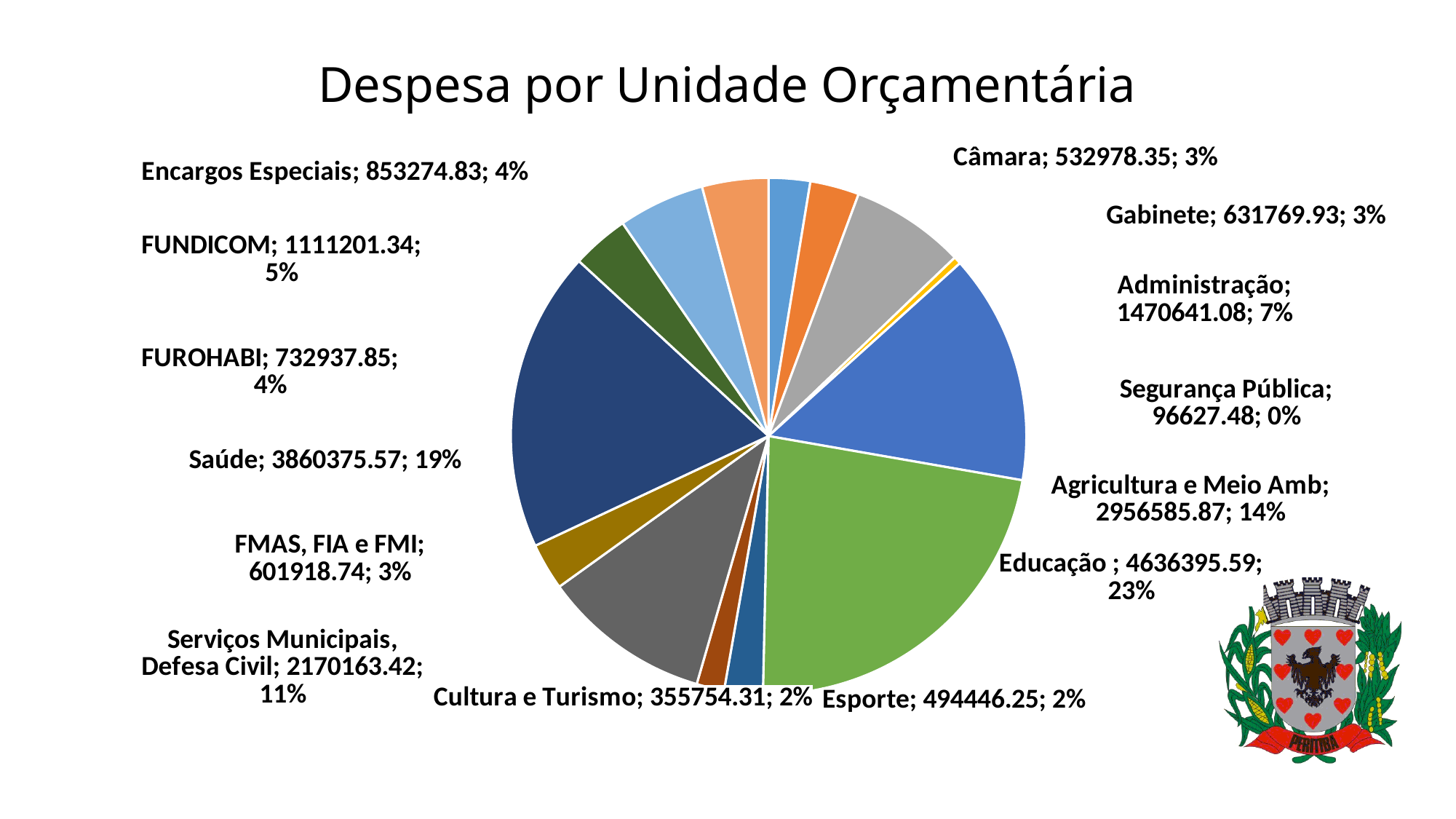
What type of chart is shown on the slide? Pie chart Which unit has the largest expense? Educação Which unit has the smallest expense? Segurança Pública What percentage share does Serviços Municipais, Defesa Civil have? 11% What is the value shown for Saúde? 3860375.57 What is the difference between the values for Educação and Saúde? 776020.02 What is the difference between the values for Administração and Gabinete? 838871.15 What percentage share does Educação have? 23% What is the value shown for Administração? 1470641.08 Which is larger, the value for Agricultura e Meio Amb or the value for Saúde? Saúde How many slices does the pie chart have? 14 What is the title of the chart? Despesa por Unidade Orçamentária